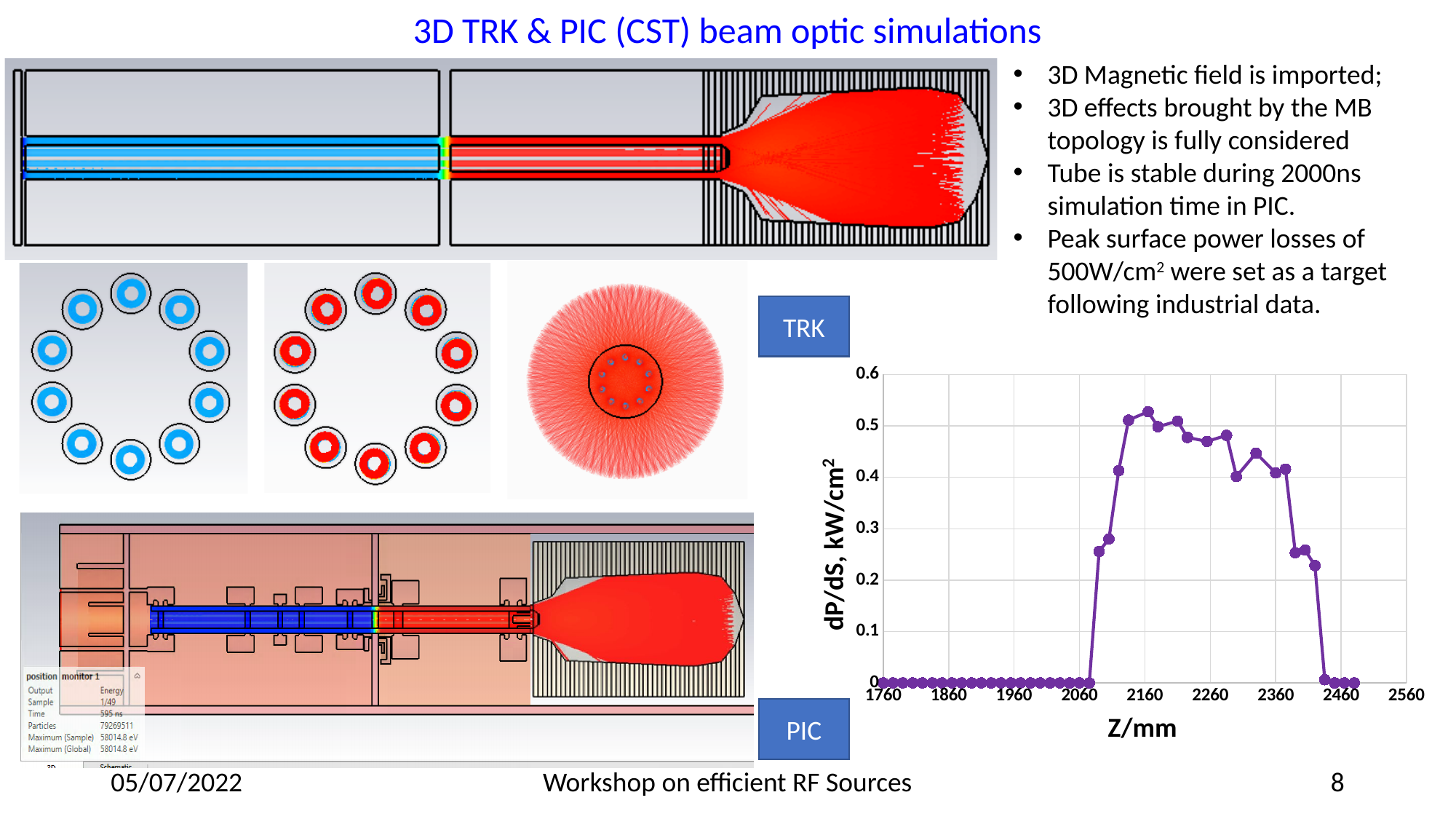
Do the dP/dS values rise or fall as Z increases from 2360 mm to 2460 mm? fall Do the dP/dS values rise or fall as Z increases from 2060 mm to 2160 mm? rise Is the value of dP/dS at Z = 2260 mm greater or less than 0.4? greater Is the value of dP/dS at Z = 2460 mm greater or less than 0.1? less Which is larger, the dP/dS value at Z = 1860 mm or at Z = 2260 mm? Z = 2260 mm Which is larger, the dP/dS value at Z = 2160 mm or at Z = 2460 mm? Z = 2160 mm Near which x-axis tick value does the curve reach its highest dP/dS? 2160 What is the label of the x axis of the chart? Z/mm Is the value of dP/dS at Z = 2160 mm greater or less than 0.3? greater What kind of chart is shown at the bottom right of the slide? line chart What is the label of the y axis of the chart? dP/dS, kW/cm2